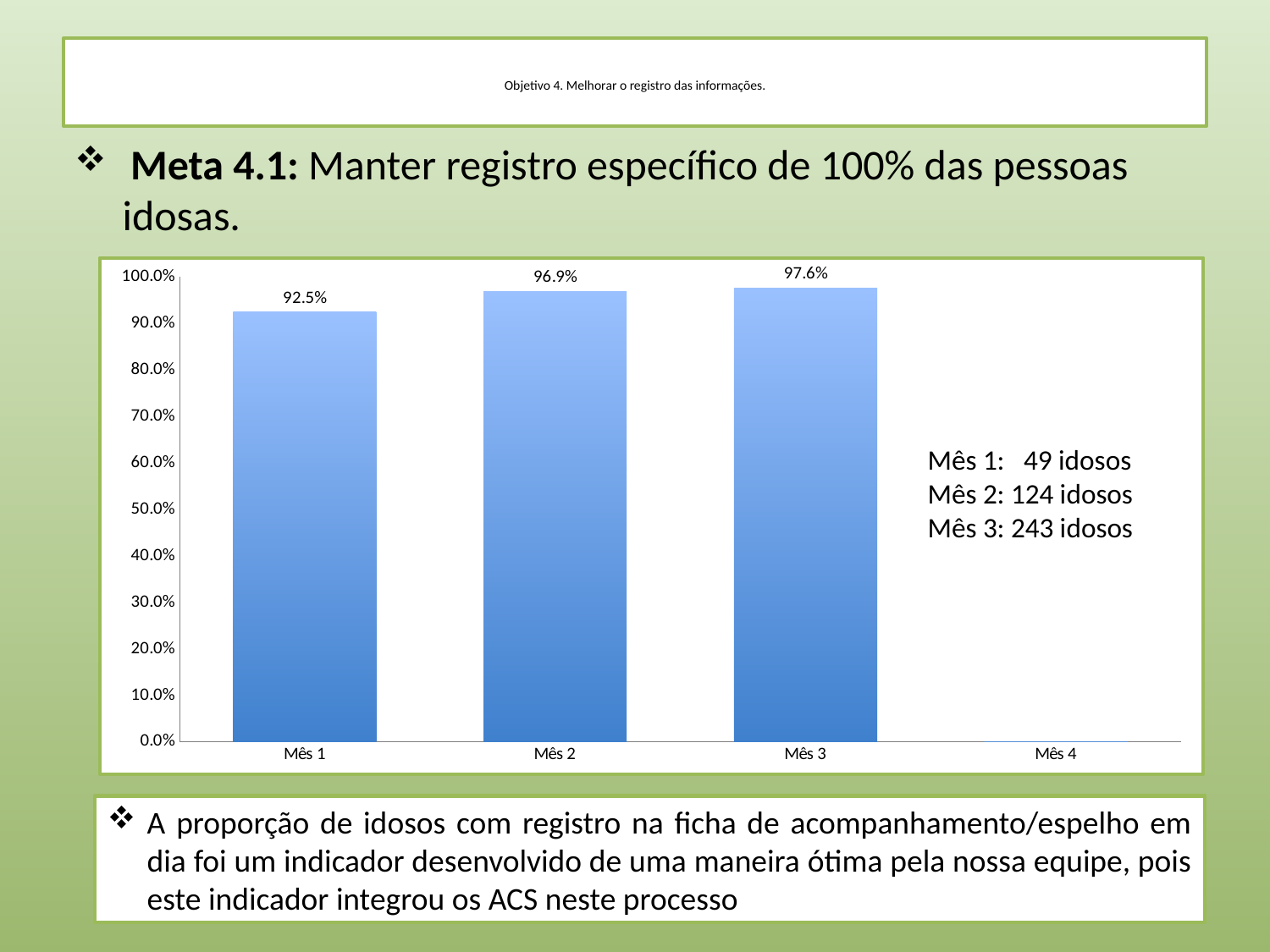
Which month has the highest value in the chart? Mês 3 What is the value shown for Mês 1? 92.5% What kind of chart is shown on the slide? Bar chart Is the value for Mês 1 greater or less than 90.0%? greater What is the difference between the values for Mês 3 and Mês 1? 5.1 percentage points What is the value shown for Mês 3? 97.6% Among Mês 1, Mês 2 and Mês 3, which month has the lowest value? Mês 1 What is the difference between the values for Mês 2 and Mês 1? 4.4 percentage points What is the value shown for Mês 2? 96.9% How many month categories are labelled on the x axis? 4 Which is larger, the value for Mês 2 or the value for Mês 1? Mês 2 Do the values rise or fall from Mês 1 to Mês 3? Rise